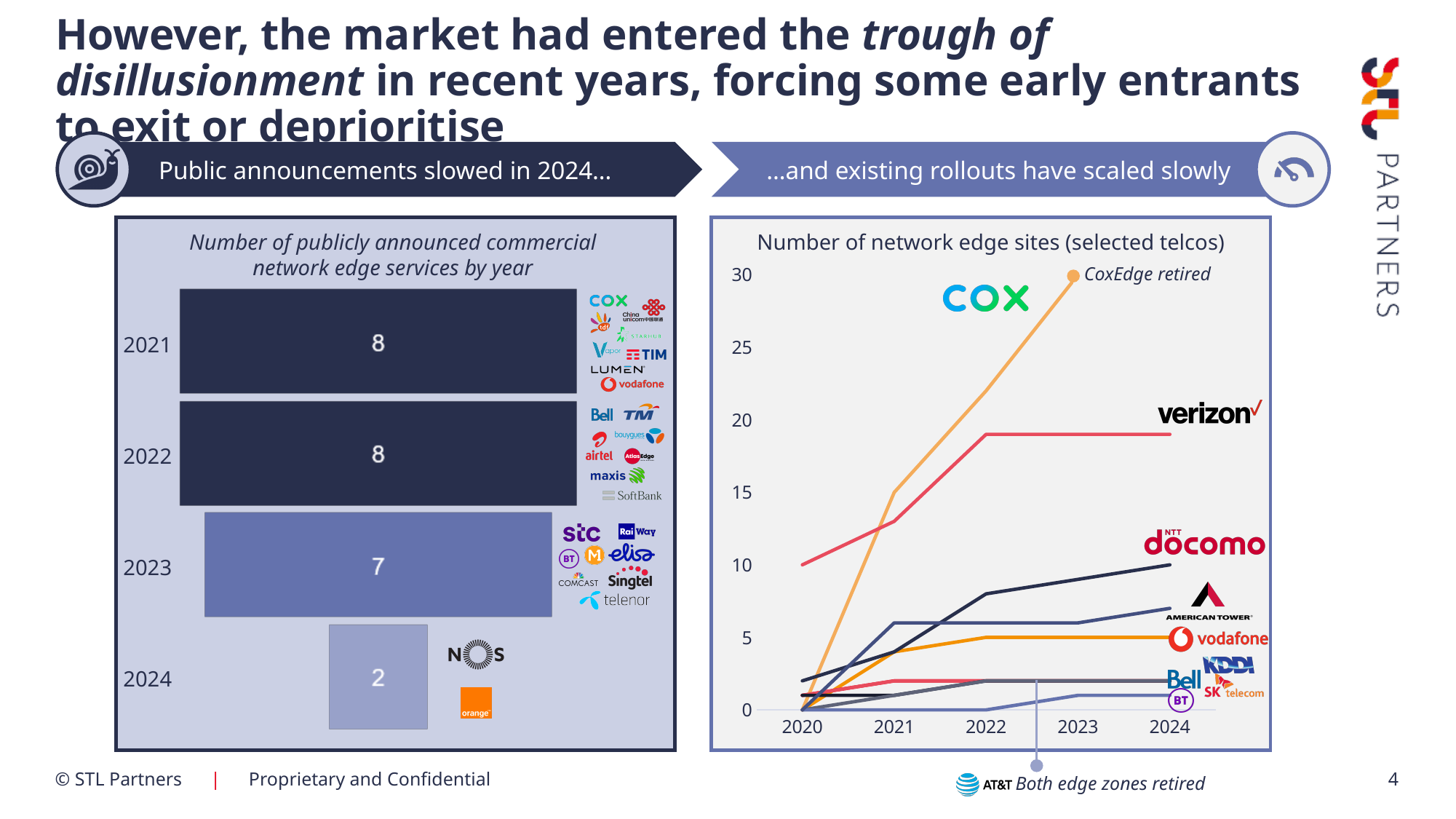
On the right chart, is the value for Verizon in 2024 greater or less than 15? greater On the right chart, which telco has the highest number of network edge sites in 2024? Cox On the left chart, do the values rise or fall from 2021 to 2024? Fall What kind of chart is the left chart, 'Number of publicly announced commercial network edge services by year'? Bar chart On the left chart, how many publicly announced commercial network edge services were there in 2024? 2 On the left chart, how many publicly announced commercial network edge services were there in 2021? 8 On the right chart, is the value for Vodafone in 2024 greater or less than 10? less On the left chart, what is the difference between the number of services announced in 2023 and in 2024? 5 On the left chart, which year has the lowest number of publicly announced commercial network edge services? 2024 What kind of chart is the right chart, 'Number of network edge sites (selected telcos)'? Line chart On the left chart, how many years are shown? 4 On the left chart, which is larger: the value for 2022 or the value for 2023? 2022